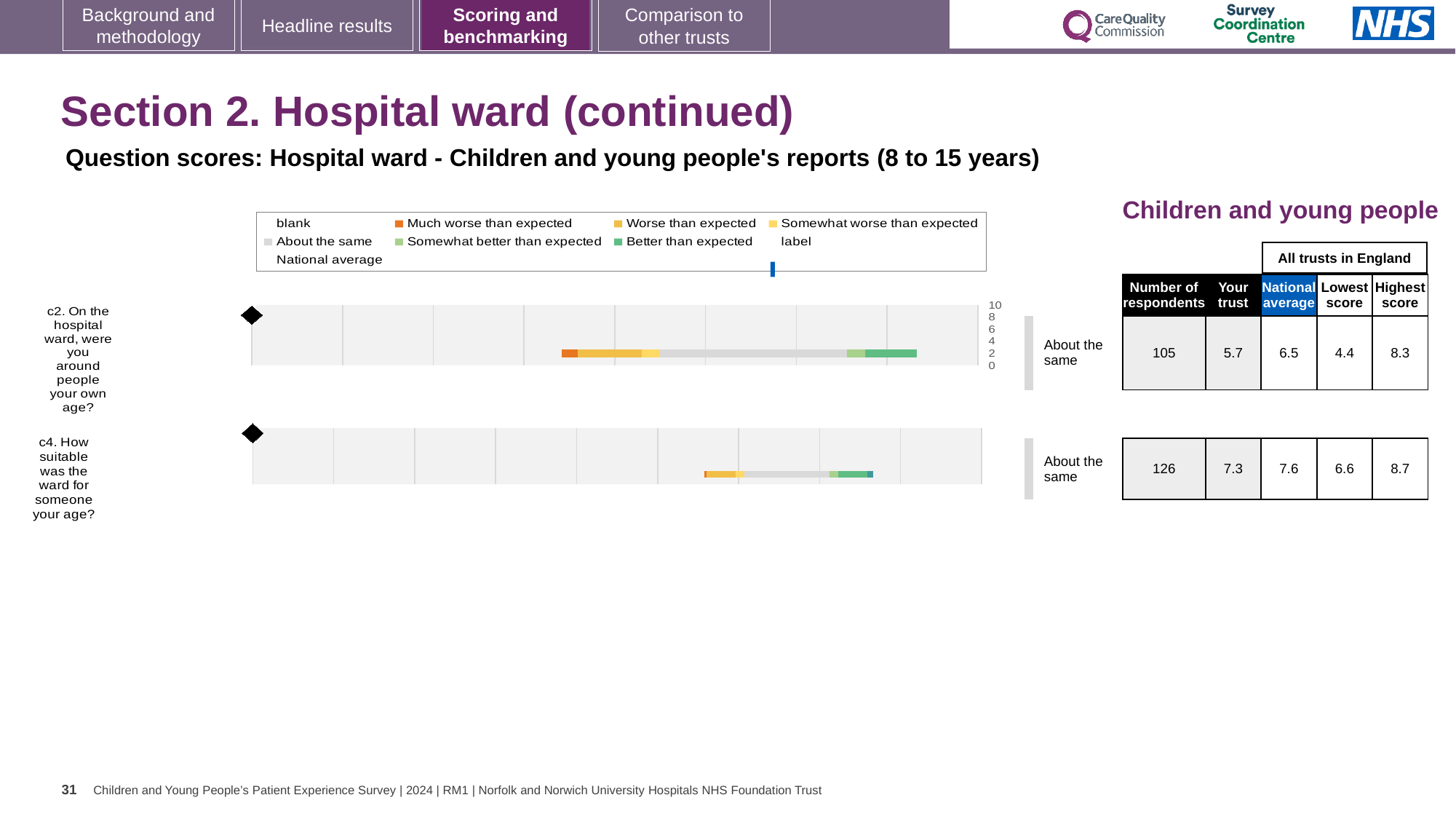
What benchmark category is shown for question c4? About the same How many questions are plotted in the chart on this slide? 2 Which question has the higher 'Your trust' score, c2 or c4? c4 How many respondents answered question c2? 105 What is the 'Your trust' score for question c2 (On the hospital ward, were you around people your own age?)? 5.7 What is the highest score across all trusts in England for question c4? 8.7 What is the difference between the highest and lowest scores across all trusts in England for question c4? 2.1 What is the lowest score across all trusts in England for question c2? 4.4 What kind of chart is used to show the question scores on this slide? bar chart What is the national average score for question c4 (How suitable was the ward for someone your age?)? 7.6 What is the difference between the national average and the 'Your trust' score for question c2? 0.8 Which question has more respondents, c2 or c4? c4